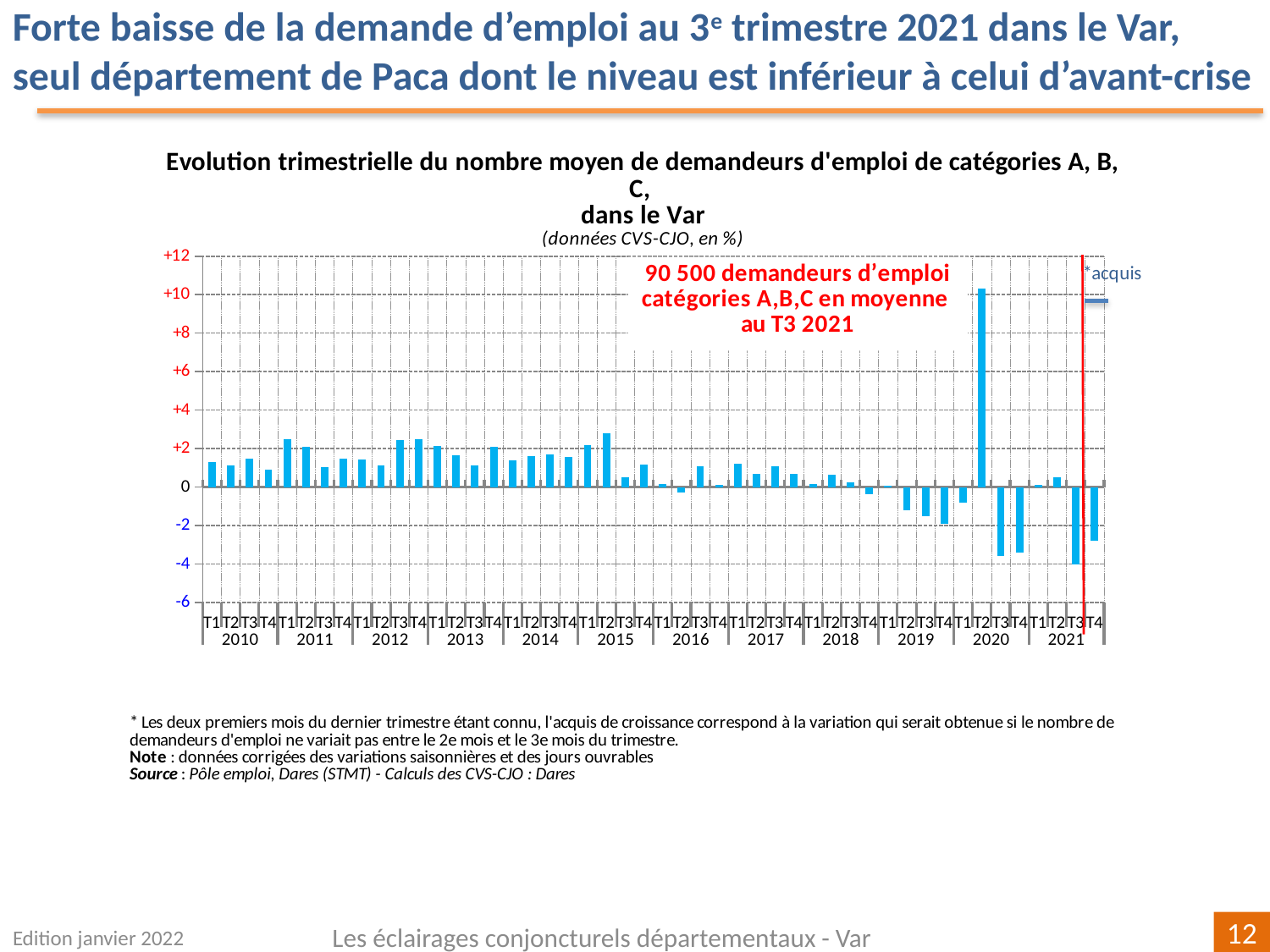
Is the value for T1 2010 greater or less than +2? less How many years are labelled along the x axis? 12 Which is larger, the value for T1 2011 or the value for T1 2016? T1 2011 Is the value for T2 2020 greater or less than +8? greater Which quarter has the lowest value in the chart? T3 2021 Which quarter has the highest value in the chart? T2 2020 Which is larger, the value for T2 2020 or the value for T3 2021? T2 2020 According to the red annotation on the chart, how many job seekers in categories A, B, C were there on average in T3 2021? 90 500 From T2 2020 to T3 2020, does the value rise or fall? fall What kind of chart is shown on the slide? bar chart Is the value for T3 2021 greater or less than -2? less